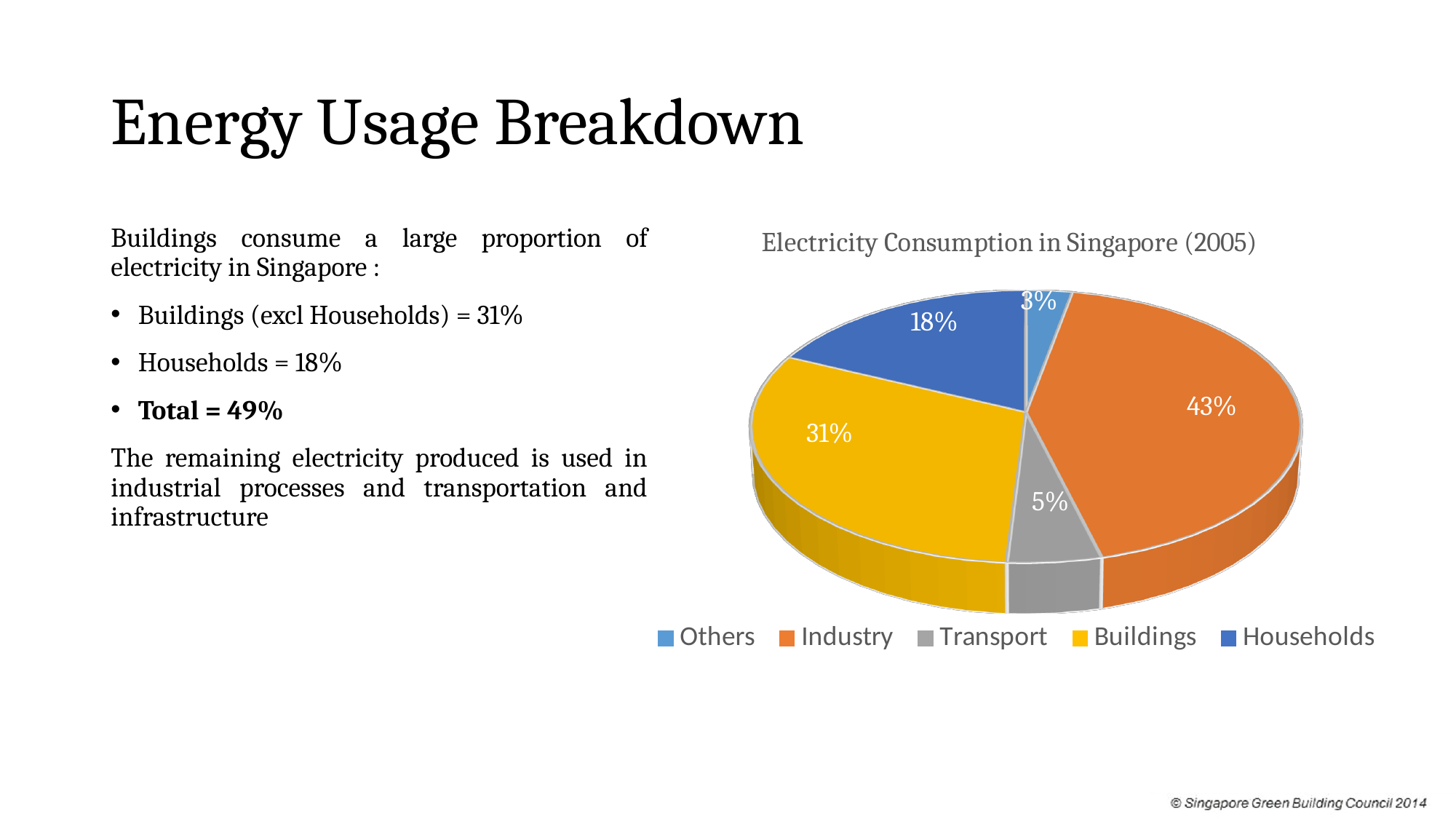
What share of electricity consumption does Households account for? 18% What share of electricity consumption does Others account for? 3% Which has a larger share, Households or Transport? Households Which category has the smallest share of electricity consumption? Others Which category has the largest share of electricity consumption? Industry What is the difference between the Industry share and the Buildings share? 12% What share of electricity consumption does Industry account for? 43% What is the title of the chart? Electricity Consumption in Singapore (2005) How many categories does the legend list? 5 What share of electricity consumption does Buildings account for? 31% What kind of chart is shown on the slide? Pie chart What share of electricity consumption does Transport account for? 5%